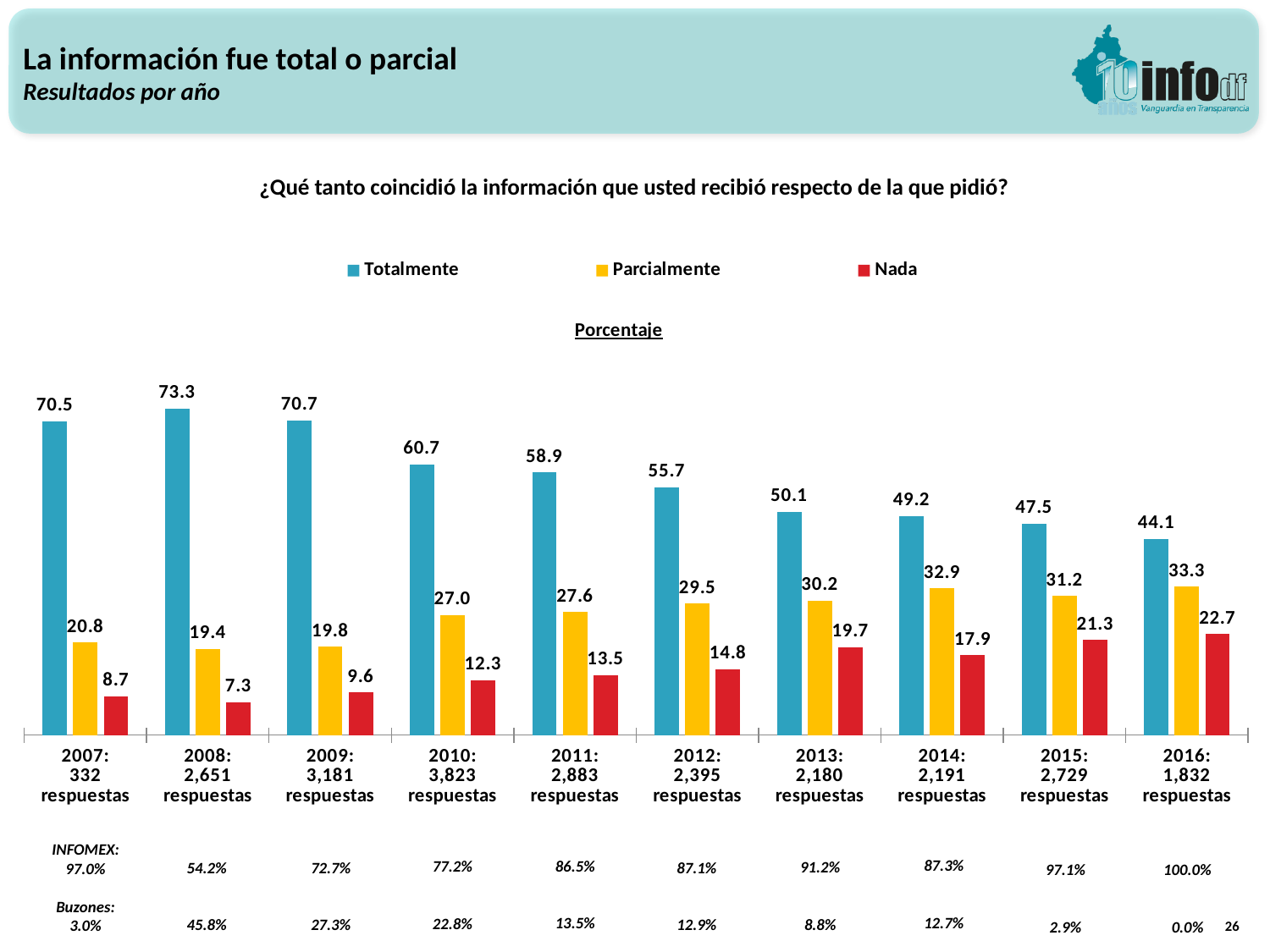
What is the difference between the Totalmente values for 2007 and 2016? 26.4 How many series does the legend list? 3 Which year has the highest value for Totalmente? 2008 What is the value for Totalmente in 2007? 70.5 Which is larger, the Parcialmente value for 2012 or for 2013? 2013 What kind of chart is shown? bar chart Does the Totalmente series rise or fall from 2009 to 2016? fall What is the value for Parcialmente in 2014? 32.9 Which colour represents the Nada series? red What is the value for Nada in 2016? 22.7 Which year has the lowest value for Nada? 2008 How many years are shown on the x axis? 10